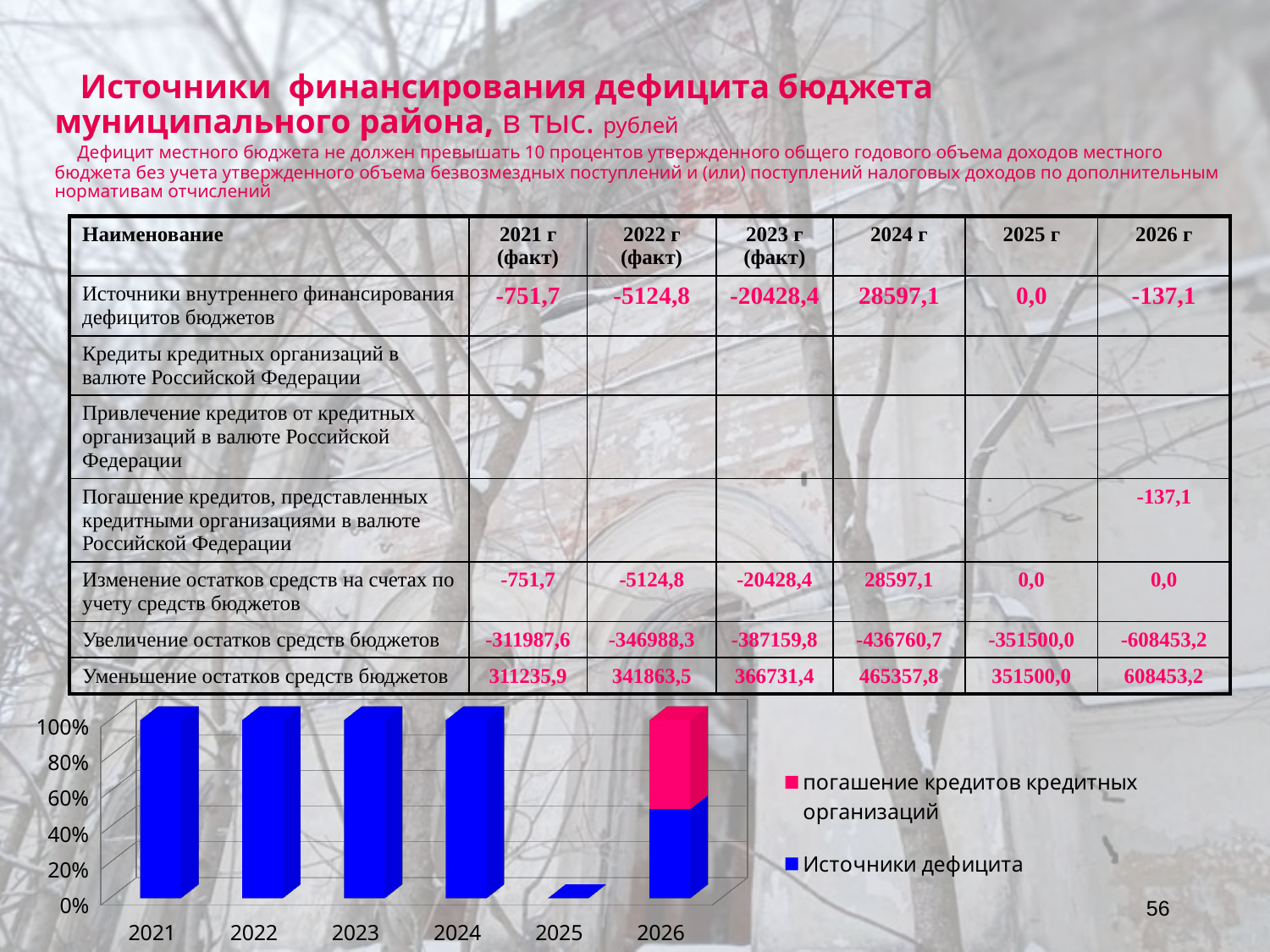
Which is larger in the chart: the Источники дефицита value for 2024 or for 2025? 2024 Is the total bar height for 2025 greater or less than 20%? less How many series does the chart legend list? 2 Is the value for погашение кредитов кредитных организаций in 2026 greater or less than 80%? less Is the value for Источники дефицита in 2021 greater or less than 80%? greater What kind of chart is shown at the bottom of the slide? Stacked bar chart How many years are shown on the x axis of the chart? 6 Which series in the chart is shown in pink? погашение кредитов кредитных организаций Which year has the lowest total bar in the chart? 2025 Which series in the chart is shown in blue? Источники дефицита In which year does the chart show a non-zero segment for погашение кредитов кредитных организаций? 2026